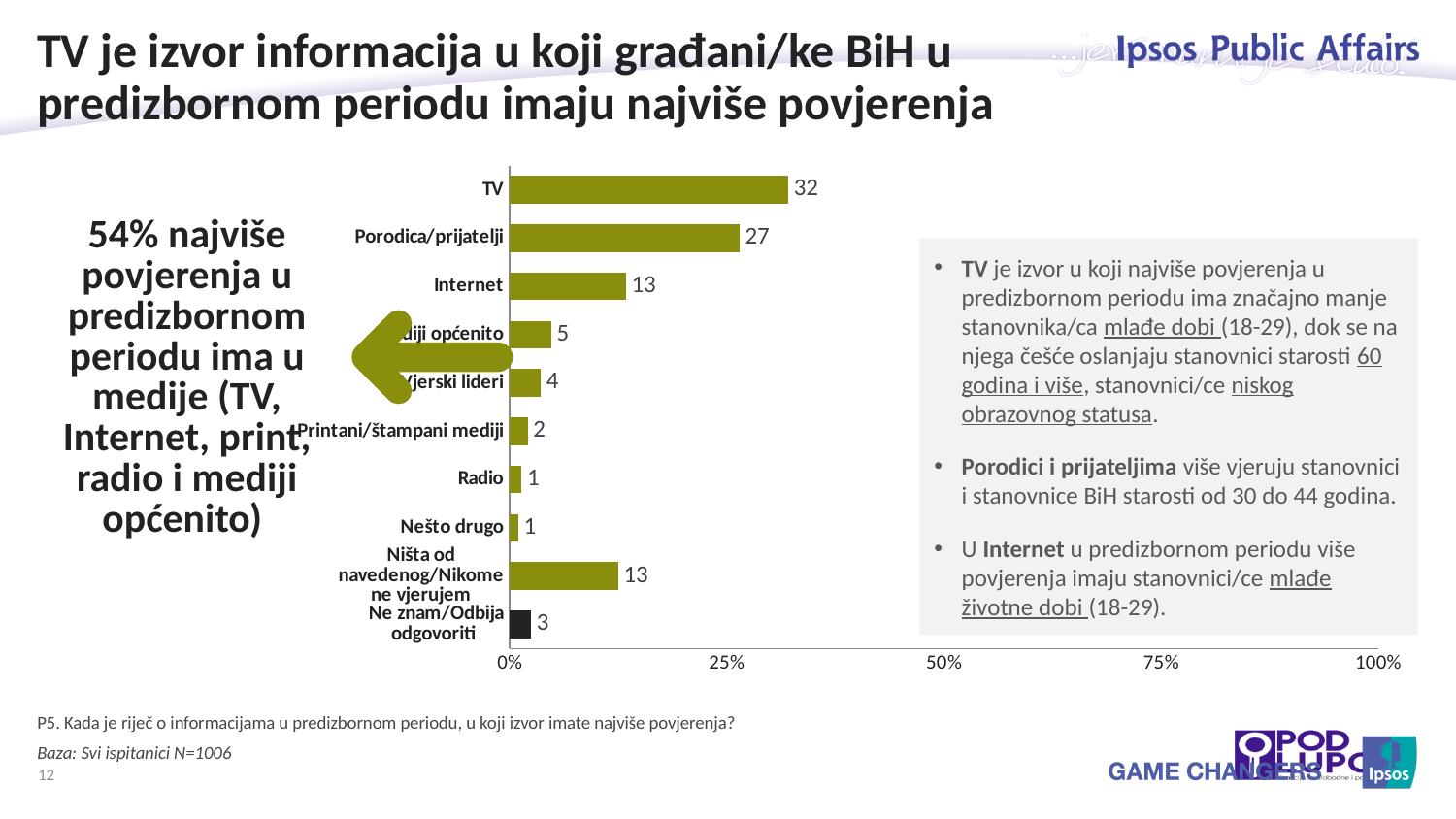
Which category has the highest value? TV What is the value shown for Printani/štampani mediji? 2 What kind of chart is shown on the slide? bar chart What is the difference between the values for TV and Porodica/prijatelji? 5 Which is larger, the value for Internet or the value for Radio? Internet What is the value shown for TV? 32 How many categories are shown in the chart? 10 What is the value shown for Internet? 13 What is the value shown for Ništa od navedenog/Nikome ne vjerujem? 13 Is the value for TV greater or less than 25%? greater What is the value shown for Porodica/prijatelji? 27 What is the value shown for Ne znam/Odbija odgovoriti? 3